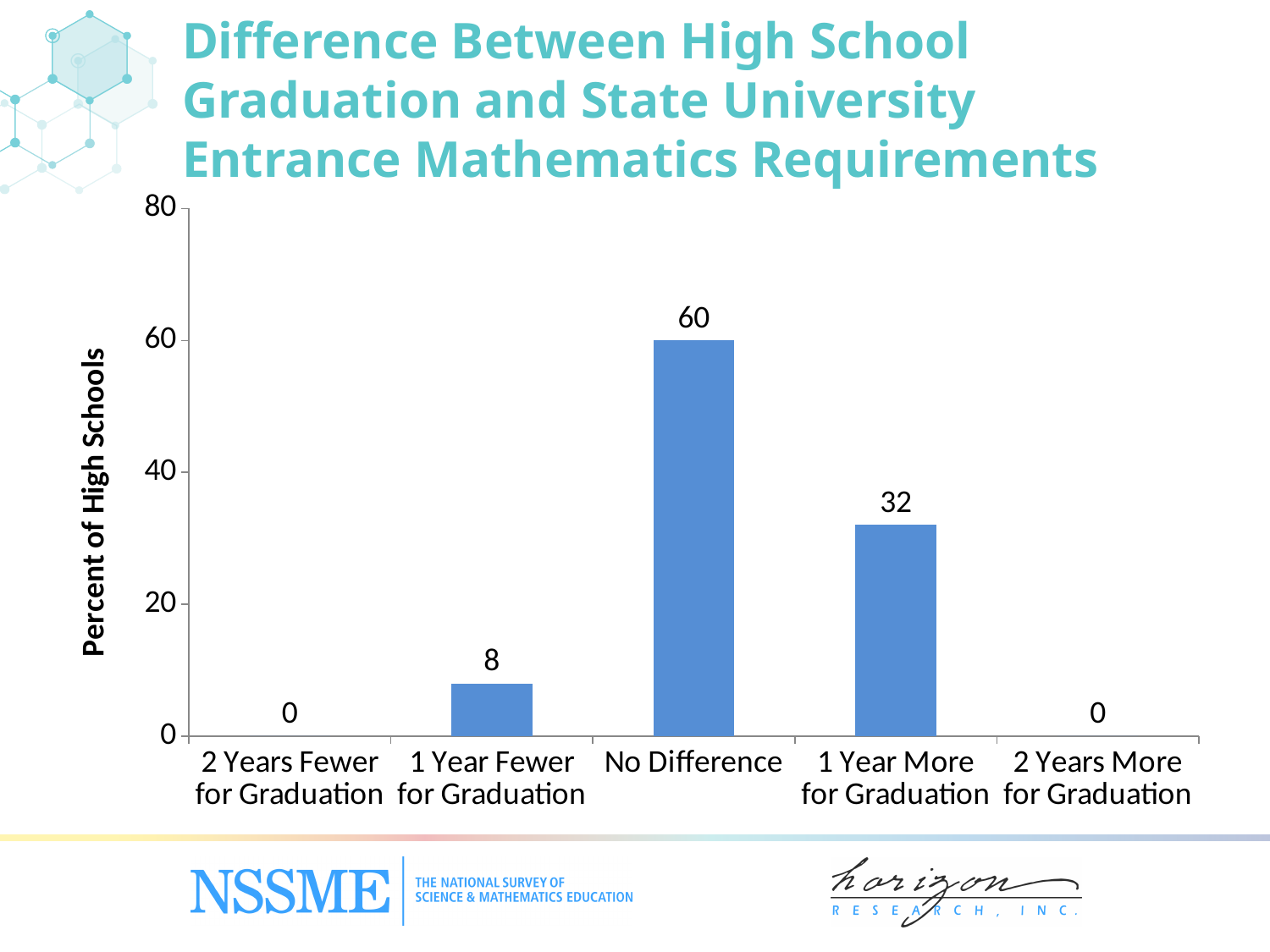
What is the label of the y axis? Percent of High Schools Which category has the highest value? No Difference What is the value for 1 Year Fewer for Graduation? 8 What is the value for No Difference? 60 What is the value for 2 Years More for Graduation? 0 What is the value for 1 Year More for Graduation? 32 What is the difference between the values for 1 Year More for Graduation and 1 Year Fewer for Graduation? 24 What is the difference between the values for No Difference and 1 Year More for Graduation? 28 Is the value for No Difference greater or less than 40? greater How many categories are shown on the x axis? 5 What kind of chart is shown on the slide? bar chart Which is larger, the value for 1 Year Fewer for Graduation or the value for 1 Year More for Graduation? 1 Year More for Graduation